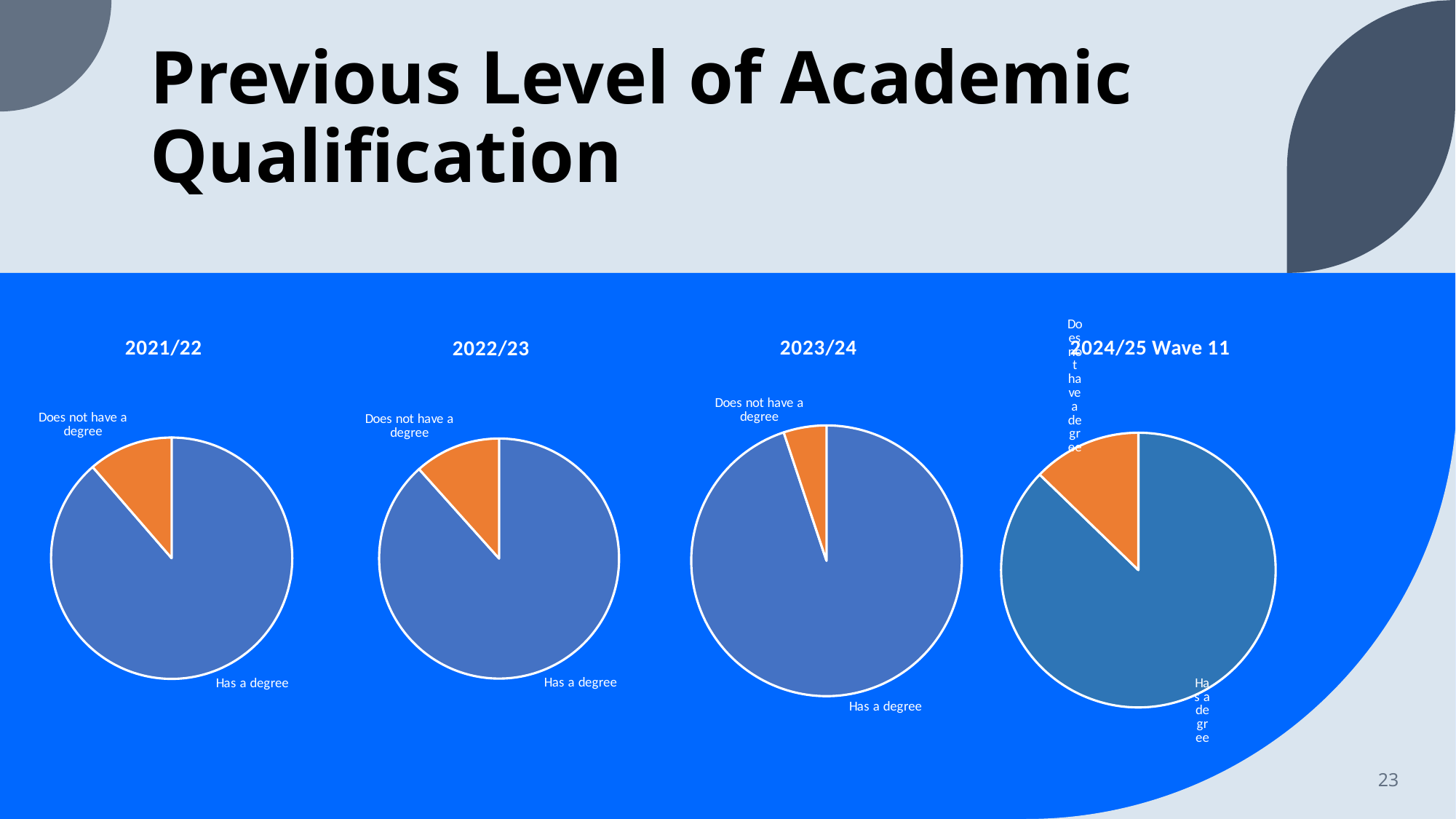
In the 2021/22 pie chart, which is larger: the 'Has a degree' slice or the 'Does not have a degree' slice? Has a degree What kind of chart is the 2021/22 chart? pie chart Is the 'Does not have a degree' slice larger in the 2021/22 pie chart or in the 2023/24 pie chart? 2021/22 In the 2024/25 Wave 11 pie chart, which category has the smallest slice? Does not have a degree What is the title of the fourth (rightmost) pie chart? 2024/25 Wave 11 In the 2021/22 pie chart, which category has the largest slice? Has a degree In the 2023/24 pie chart, which category has the largest slice? Has a degree In the 2022/23 pie chart, which category has the smallest slice? Does not have a degree What kind of chart is the 2023/24 chart? pie chart What colour is the 'Does not have a degree' slice in the 2022/23 pie chart? orange How many pie charts are shown on the slide? 4 How many slices does the 2022/23 pie chart have? 2